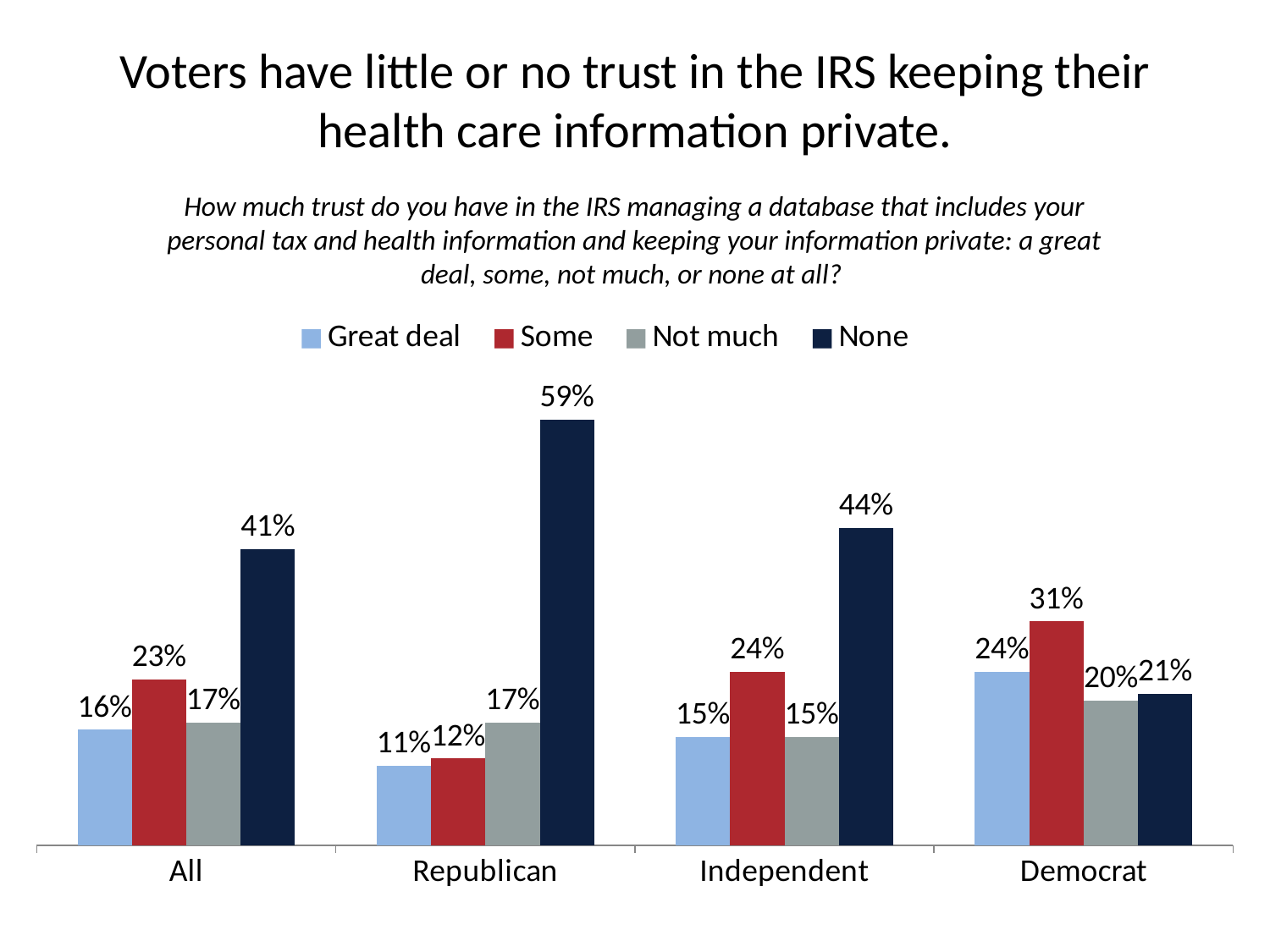
What is the value for 'Great deal' among All voters? 16% What is the value for 'Some' among Democrat voters? 31% What is the difference between 'None' and 'Great deal' for All voters? 25 percentage points How many voter groups are shown on the x axis? 4 What kind of chart is shown on the slide? Bar chart Which is larger for Independent voters: 'Some' or 'Not much'? Some Which group has the lowest value for 'Great deal'? Republican How many series does the legend list? 4 What percentage of Republican voters say they have no trust (None) in the IRS keeping their health care information private? 59% Which group has the highest value for 'None'? Republican What is the difference between the 'None' values for Republican and Democrat voters? 38 percentage points Which legend entry is shown in dark navy? None